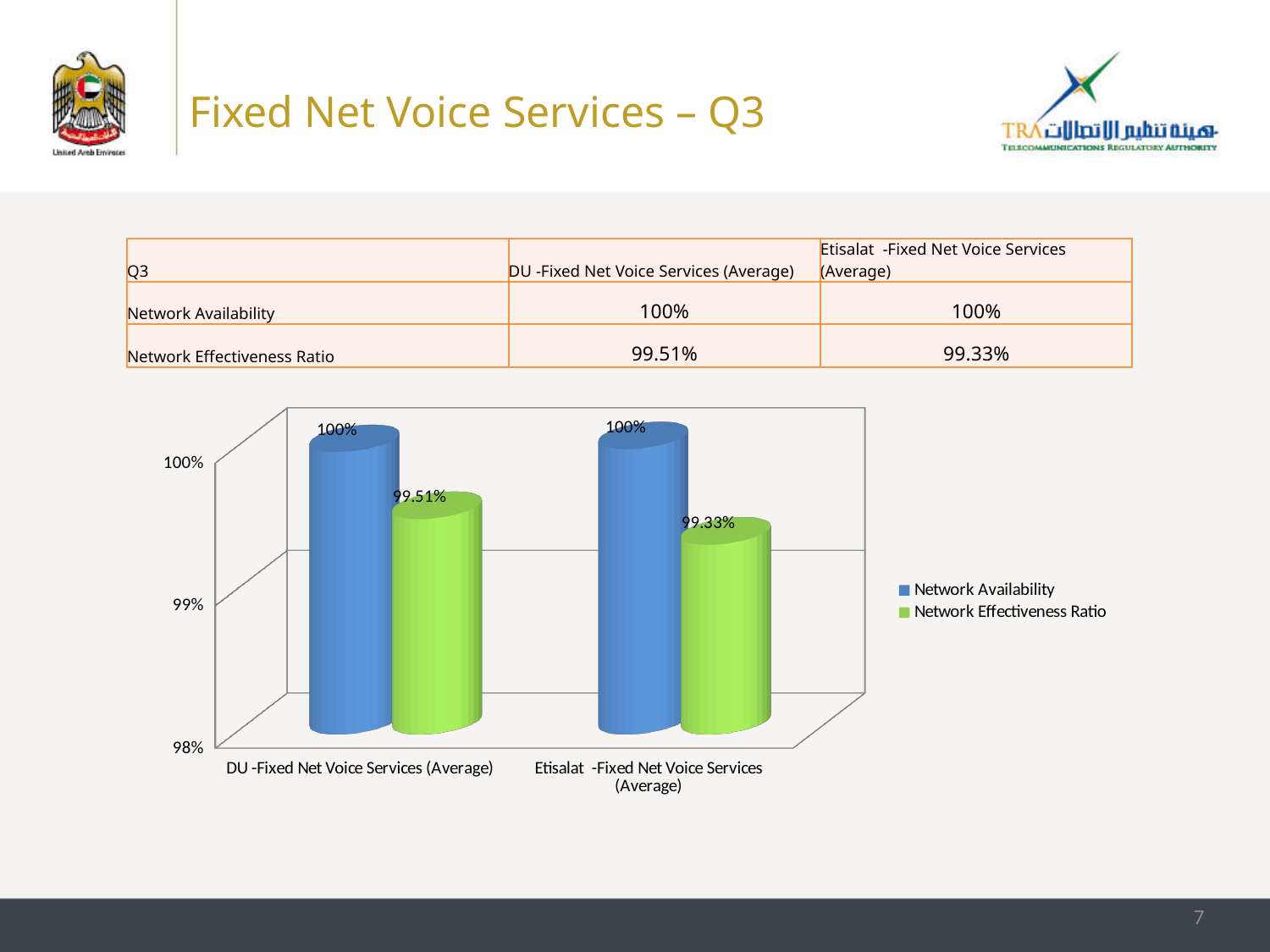
How many categories are shown on the x axis of the chart? 2 What is the Network Availability value for DU - Fixed Net Voice Services (Average)? 100% What is the Network Effectiveness Ratio for Etisalat - Fixed Net Voice Services (Average)? 99.33% How many series does the legend list? 2 What is the difference between Network Availability and Network Effectiveness Ratio for Etisalat? 0.67% What is the difference between the Network Effectiveness Ratio of DU and Etisalat? 0.18% Which operator has the higher Network Effectiveness Ratio, DU or Etisalat? DU Which colour represents Network Effectiveness Ratio in the chart? Green What kind of chart is shown on the slide? Bar chart Which category has the lowest Network Effectiveness Ratio? Etisalat - Fixed Net Voice Services (Average) What is the Network Effectiveness Ratio for DU - Fixed Net Voice Services (Average)? 99.51% What is the Network Availability value for Etisalat - Fixed Net Voice Services (Average)? 100%